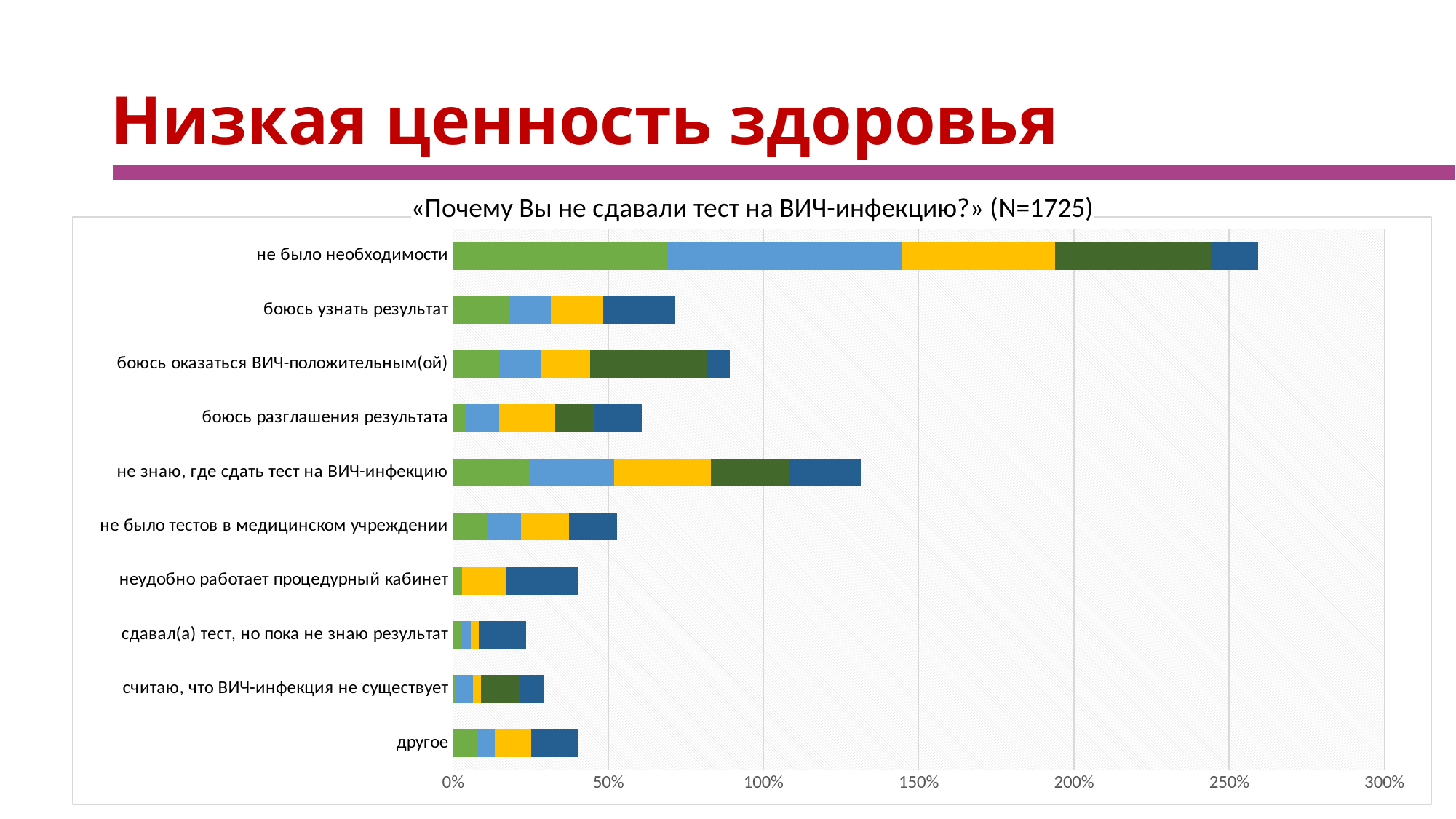
Is the total bar for "другое" greater or less than 50%? less Is the total bar for "боюсь узнать результат" greater or less than 50%? greater Is the total bar for "не было необходимости" greater or less than 200%? greater What is the highest value shown on the horizontal axis? 300% What kind of chart is shown on the slide? Stacked bar chart How many categories (reasons) are listed on the chart? 10 What is the title of the chart? «Почему Вы не сдавали тест на ВИЧ-инфекцию?» (N=1725) Which category has the longest total bar? не было необходимости Which total bar is longer: "не знаю, где сдать тест на ВИЧ-инфекцию" or "боюсь оказаться ВИЧ-положительным(ой)"? не знаю, где сдать тест на ВИЧ-инфекцию